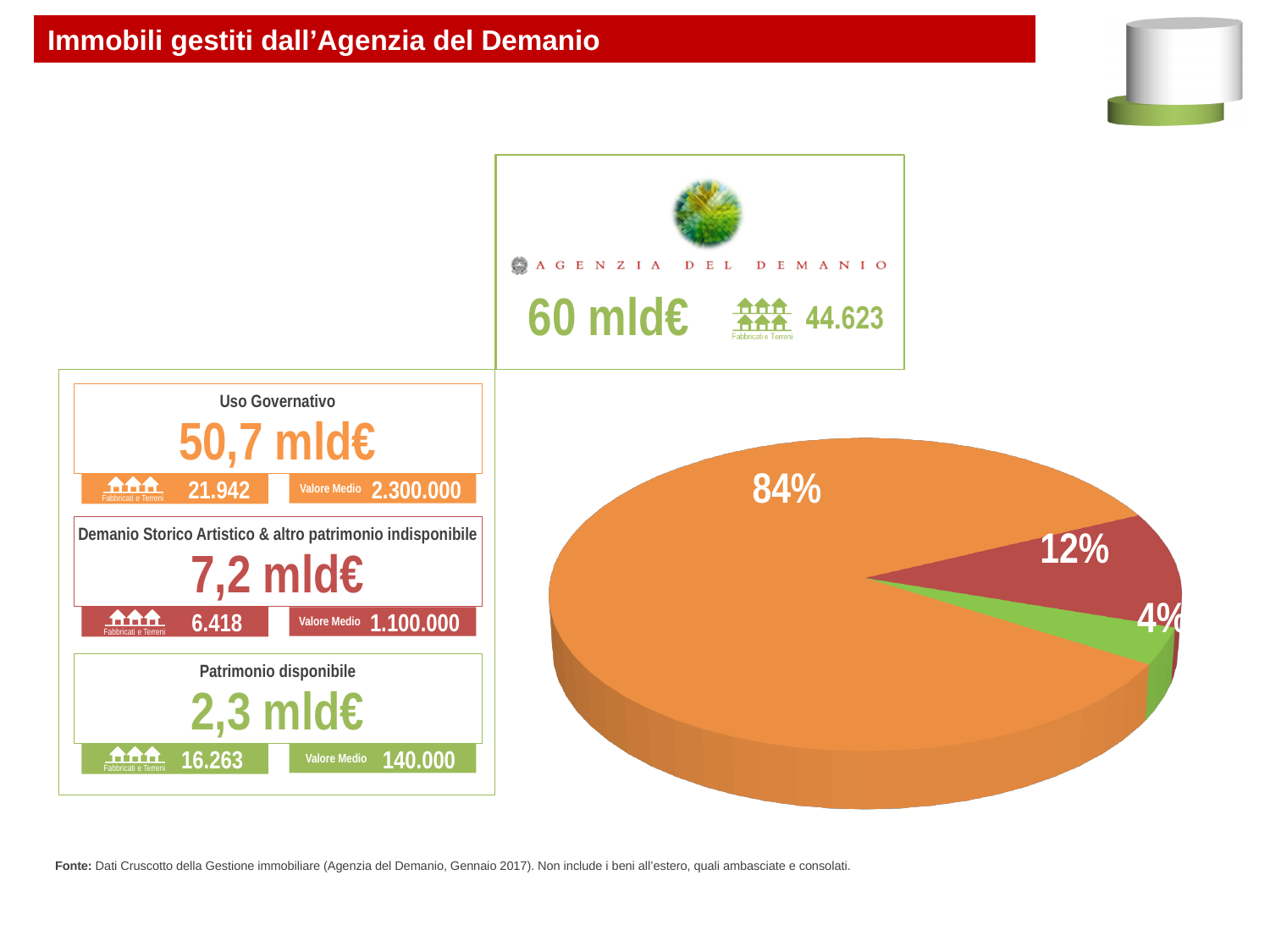
What share of the pie chart does the orange slice represent? 84% What share of the pie chart does the red slice represent? 12% What is the difference in percentage points between the red slice and the green slice of the pie chart? 8 percentage points What is the difference in percentage points between the largest slice and the red slice of the pie chart? 72 percentage points What is the share of the smallest slice of the pie chart? 4% What is the title of the slide containing the pie chart? Immobili gestiti dall'Agenzia del Demanio What colour is the largest slice of the pie chart? Orange What kind of chart is shown on the slide? Pie chart What is the share of the largest slice of the pie chart? 84% How many slices does the pie chart have? 3 Which slice of the pie chart is larger, the red one or the green one? The red one What share of the pie chart does the green slice represent? 4%